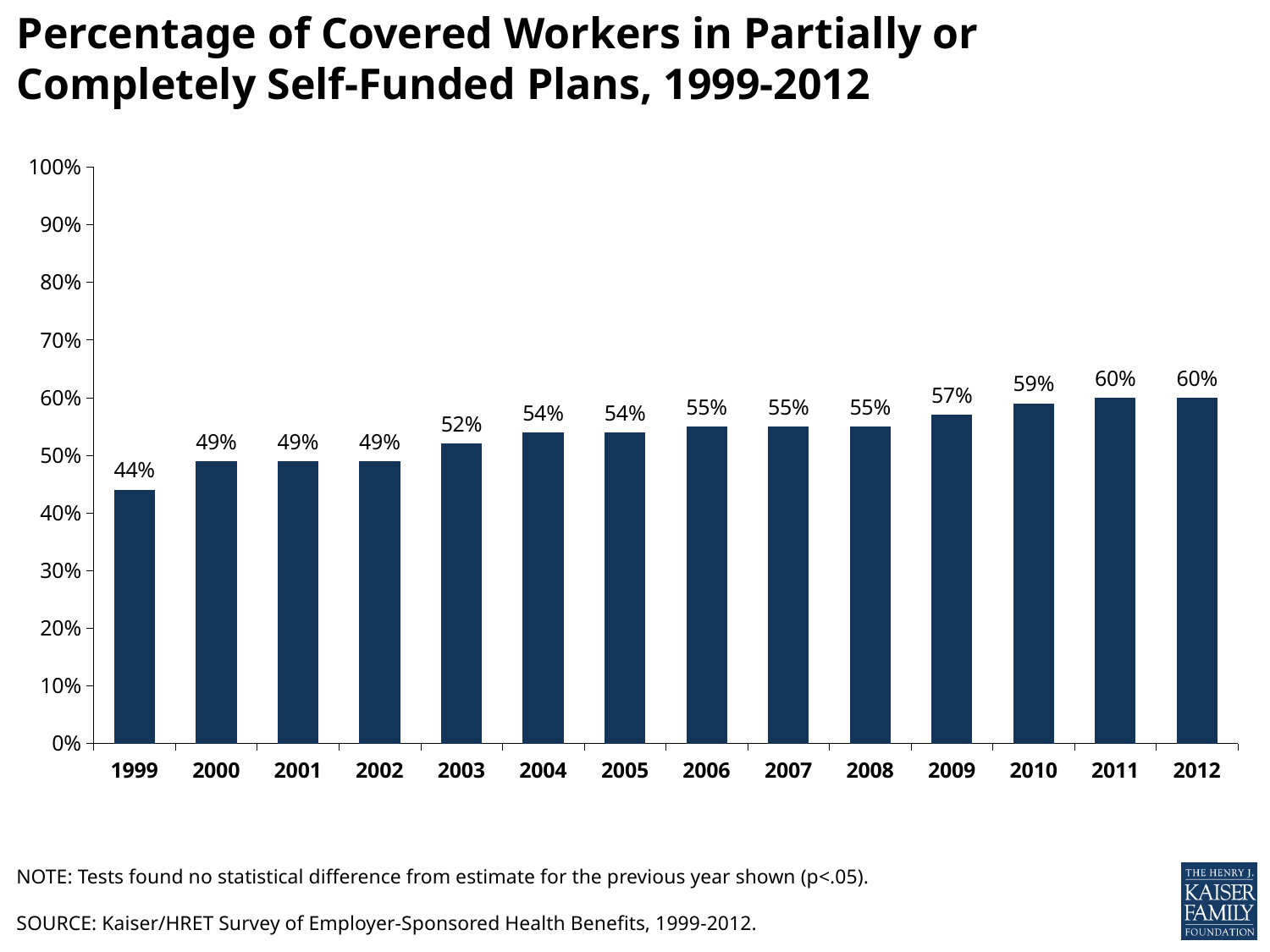
Which year has the lowest percentage of covered workers in self-funded plans? 1999 What is the difference between the values for 2012 and 1999? 16 percentage points What is the highest value shown on the chart? 60% Which is larger, the value for 2004 or the value for 2002? 2004 Is the value for 2006 greater or less than 50%? greater What percentage of covered workers were in partially or completely self-funded plans in 1999? 44% Do the values generally rise or fall from 1999 to 2012? Rise What is the value shown for 2009? 57% What kind of chart is shown on the slide? Bar chart What is the difference between the values for 2010 and 2009? 2 percentage points What is the value shown for 2003? 52% How many years are shown on the x axis? 14